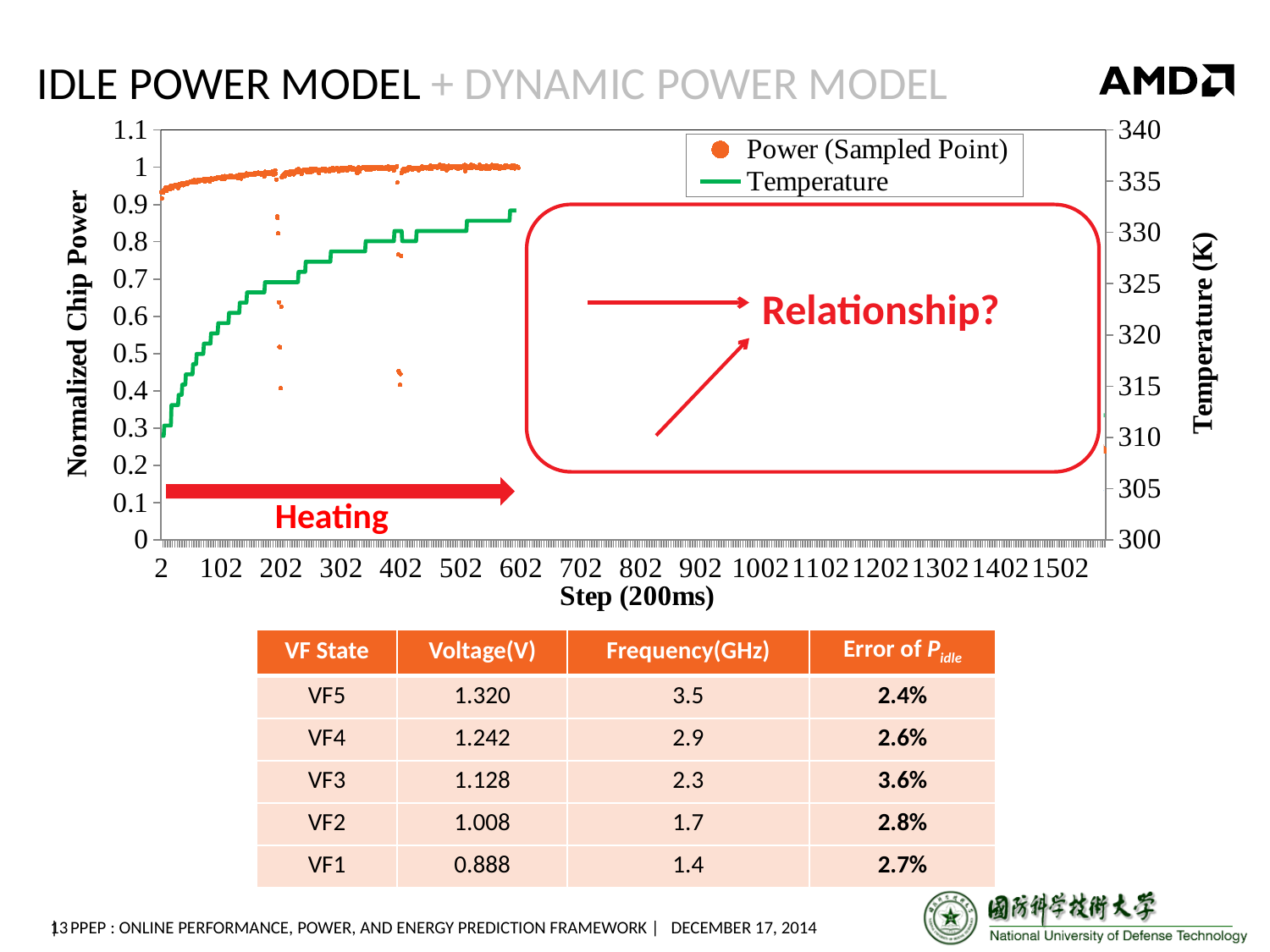
How many series does the chart legend list? 2 Is the Temperature value at step 2 greater or less than 315 K? less Which series is drawn as a green line in the chart? Temperature Is the Temperature value at around step 602 greater or less than 325 K? greater What are the two series named in the chart legend? Power (Sampled Point) and Temperature Is the Normalized Chip Power value for the sampled points around step 502 greater or less than 0.9? greater What is the title of the left vertical axis of the chart? Normalized Chip Power Does the Temperature series rise or fall as the step increases from 2 to 602? rise